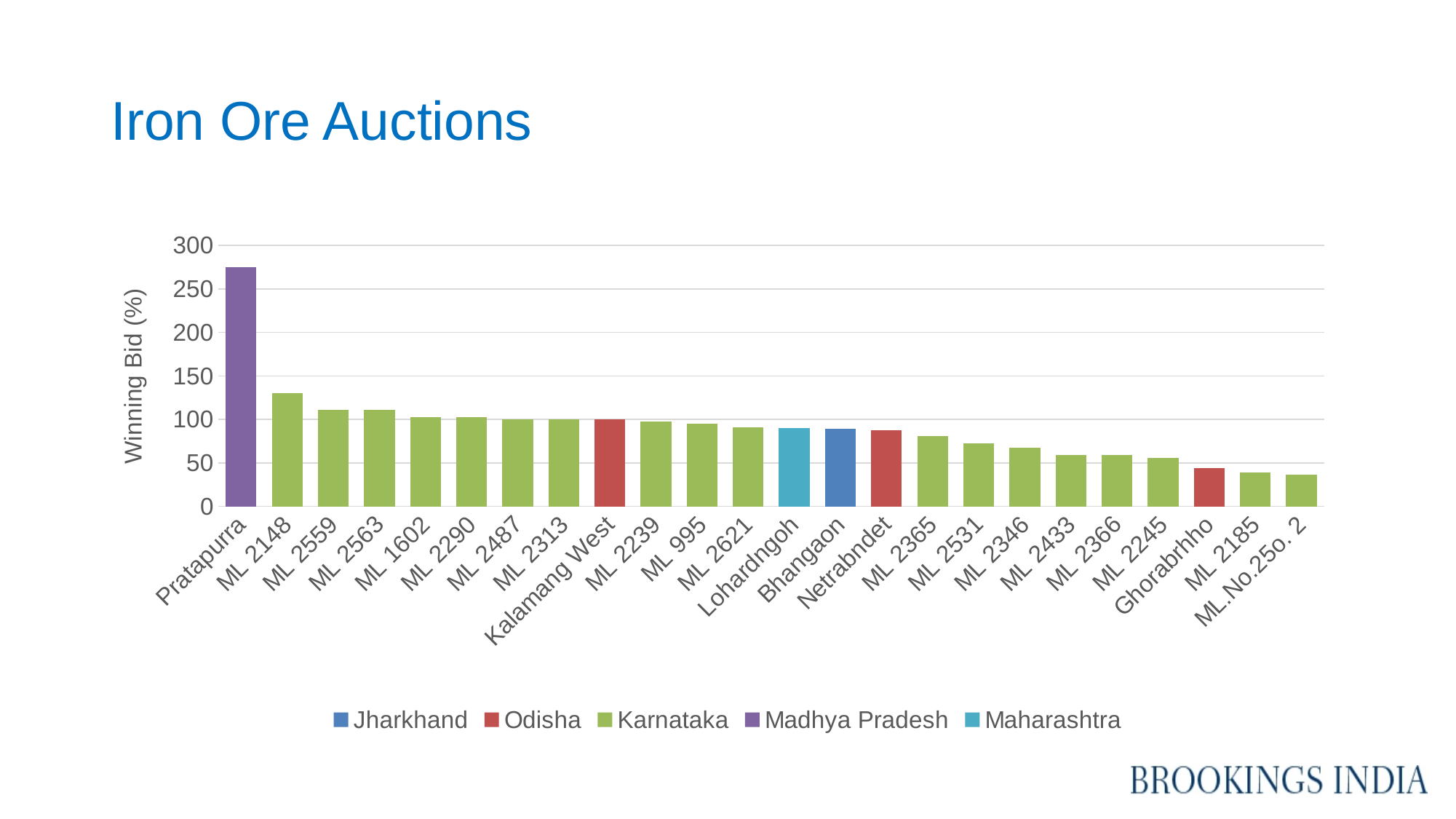
Do the winning bids rise or fall moving from left to right along the x axis? Fall How many series does the legend list? 5 Which has the larger winning bid, ML 2148 or ML 2559? ML 2148 What is the label on the vertical axis? Winning Bid (%) Which mine has the highest winning bid? Pratapurra Is the winning bid for Ghorabrhho greater or less than 50? less Which has the larger winning bid, Ghorabrhho or ML 2365? ML 2365 Is the winning bid for ML 2148 greater or less than 100? greater Is the winning bid for ML 2365 greater or less than 100? less How many mines (categories) are plotted on the x axis? 24 What kind of chart is shown on the slide? Bar chart